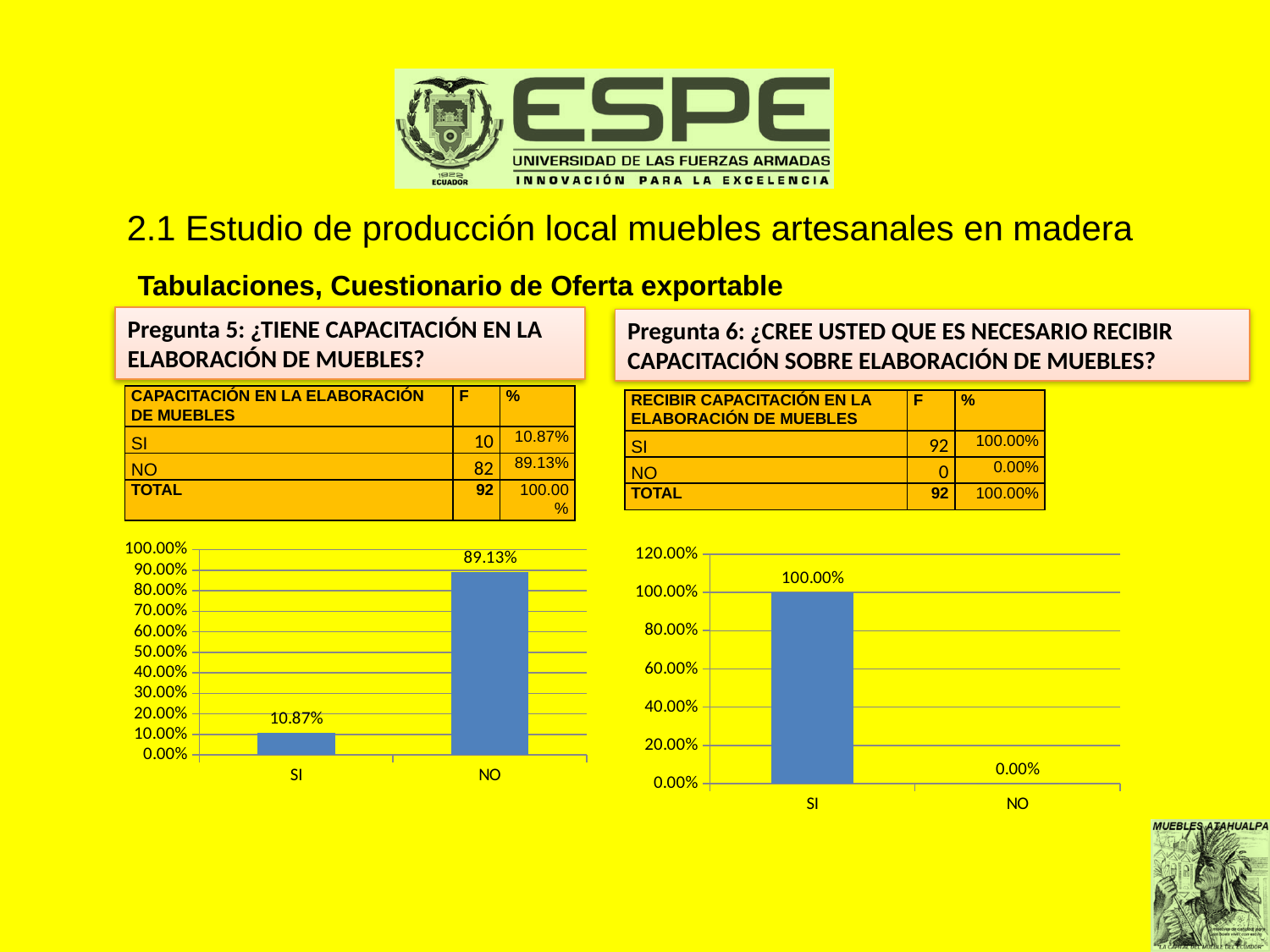
In the right chart (Pregunta 6), which category has the lowest value? NO In the left chart (Pregunta 5), is the value for SI greater or less than 20.00%? less In the left chart (Pregunta 5), what is the value for SI? 10.87% In the left chart (Pregunta 5), which category has the highest value? NO What is the highest tick value on the y axis of the right chart (Pregunta 6)? 120.00% How many categories are shown on the x axis of the right chart (Pregunta 6)? 2 In the left chart (Pregunta 5), what is the difference between the values for NO and SI? 78.26% In the right chart (Pregunta 6), which is larger, the value for SI or the value for NO? SI In the right chart (Pregunta 6), what is the value for NO? 0.00% In the left chart (Pregunta 5), what is the value for NO? 89.13% What kind of chart is the left chart (Pregunta 5)? bar chart In the right chart (Pregunta 6), what is the value for SI? 100.00%